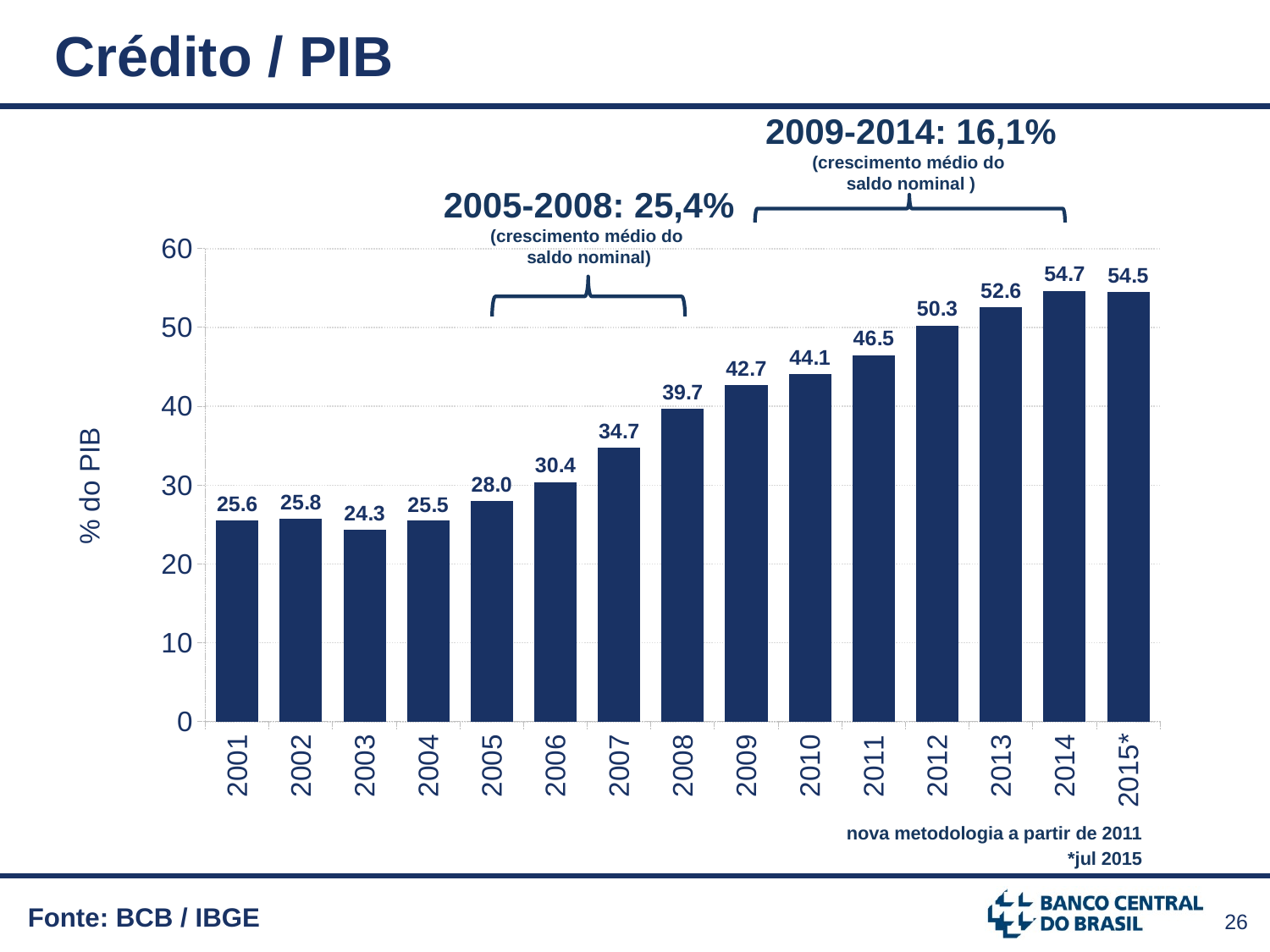
Do the values generally rise or fall from 2004 to 2014? rise What is the value for 2008? 39.7 Which year has the highest value? 2014 What is the value for 2012? 50.3 Which is larger, the value for 2007 or the value for 2009? 2009 What kind of chart is this? bar chart How many years are shown on the x axis? 15 What is the value for 2003? 24.3 Is the value for 2011 greater or less than 40? greater What is the label of the y axis? % do PIB What is the difference between the values for 2014 and 2001? 29.1 Which year has the lowest value? 2003